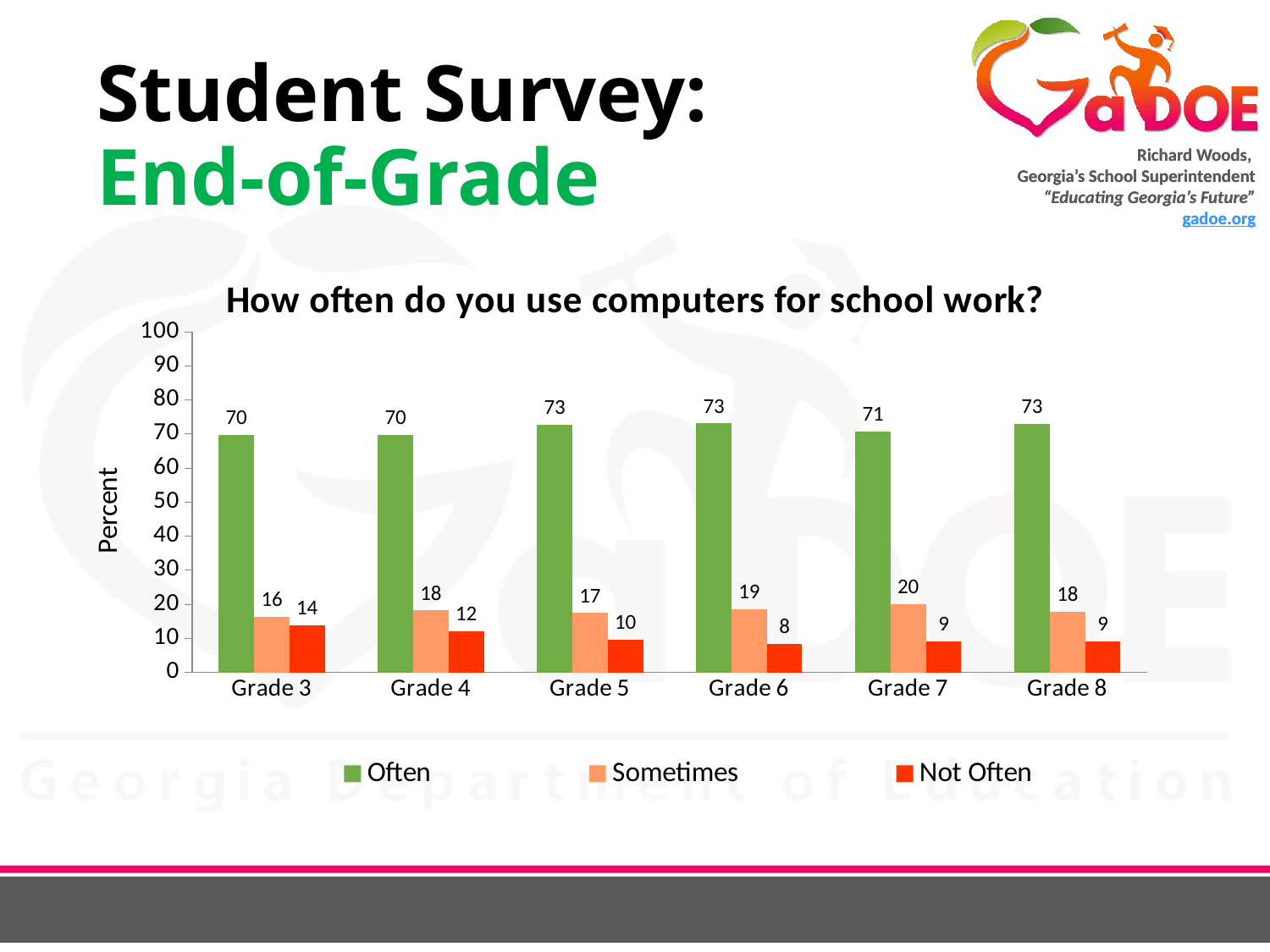
Which is larger, the Not Often value for Grade 3 or for Grade 8? Grade 3 How many grades are shown on the x axis? 6 What is the value for Not Often in Grade 3? 14 Is the value for Often in Grade 6 greater or less than 60? greater What is the difference between the Often and Not Often values in Grade 4? 58 What is the value for Sometimes in Grade 7? 20 Which grade has the lowest value for Not Often? Grade 6 How many series does the legend list? 3 What is the title of the chart? How often do you use computers for school work? What is the value for Often in Grade 5? 73 Which grade has the highest value for Sometimes? Grade 7 What kind of chart is shown? bar chart